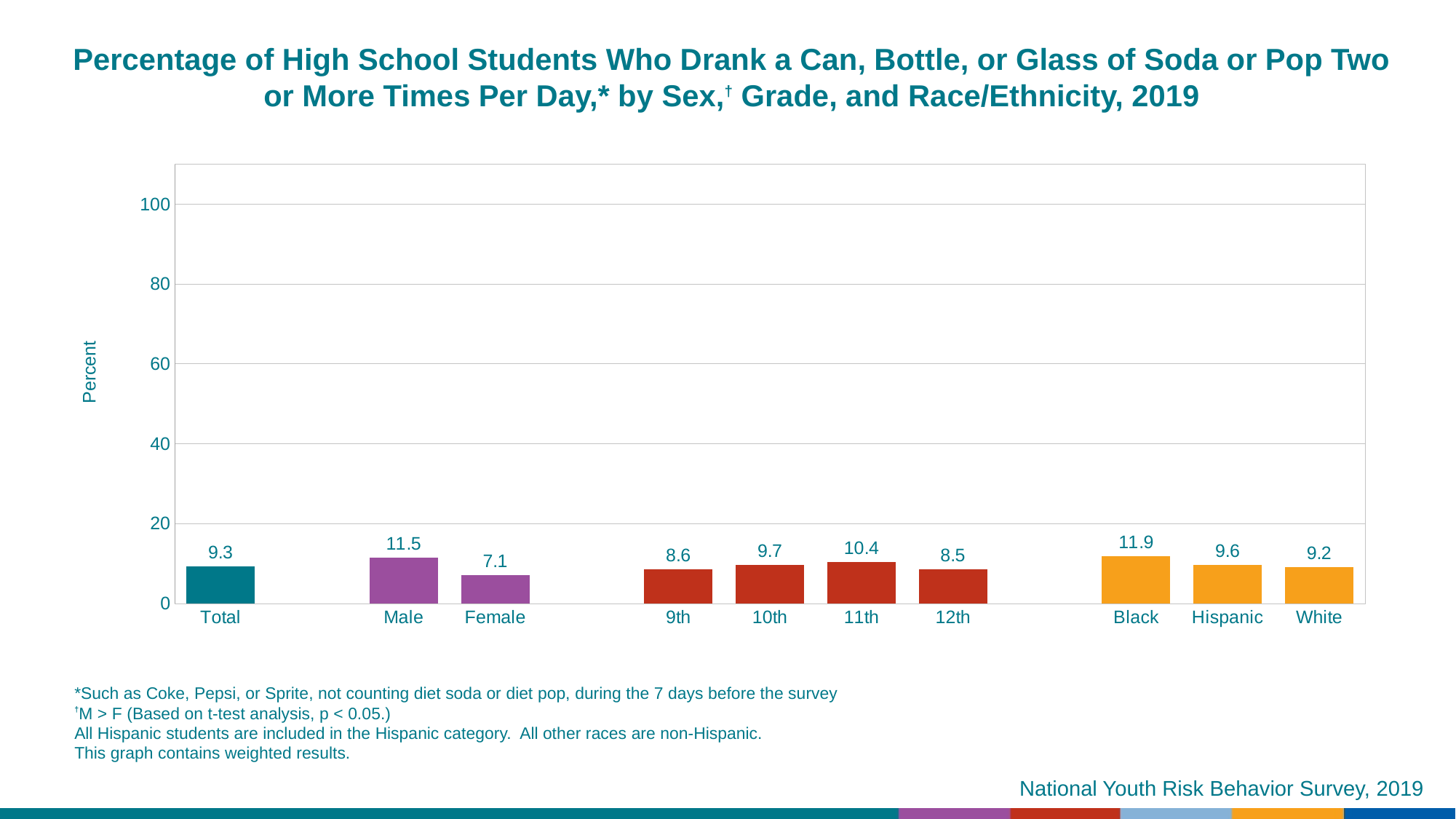
Is the value for Black greater or less than 20? less How many categories are shown on the x axis? 10 What is the value for Female? 7.1 What is the difference between the Male and Female values? 4.4 What is the label of the y axis? Percent What is the value for Total? 9.3 Which category has the highest value? Black Which category has the lowest value? Female What is the value for Male? 11.5 What is the value for 11th grade? 10.4 Which is larger, the value for 10th grade or 12th grade? 10th What kind of chart is this? bar chart